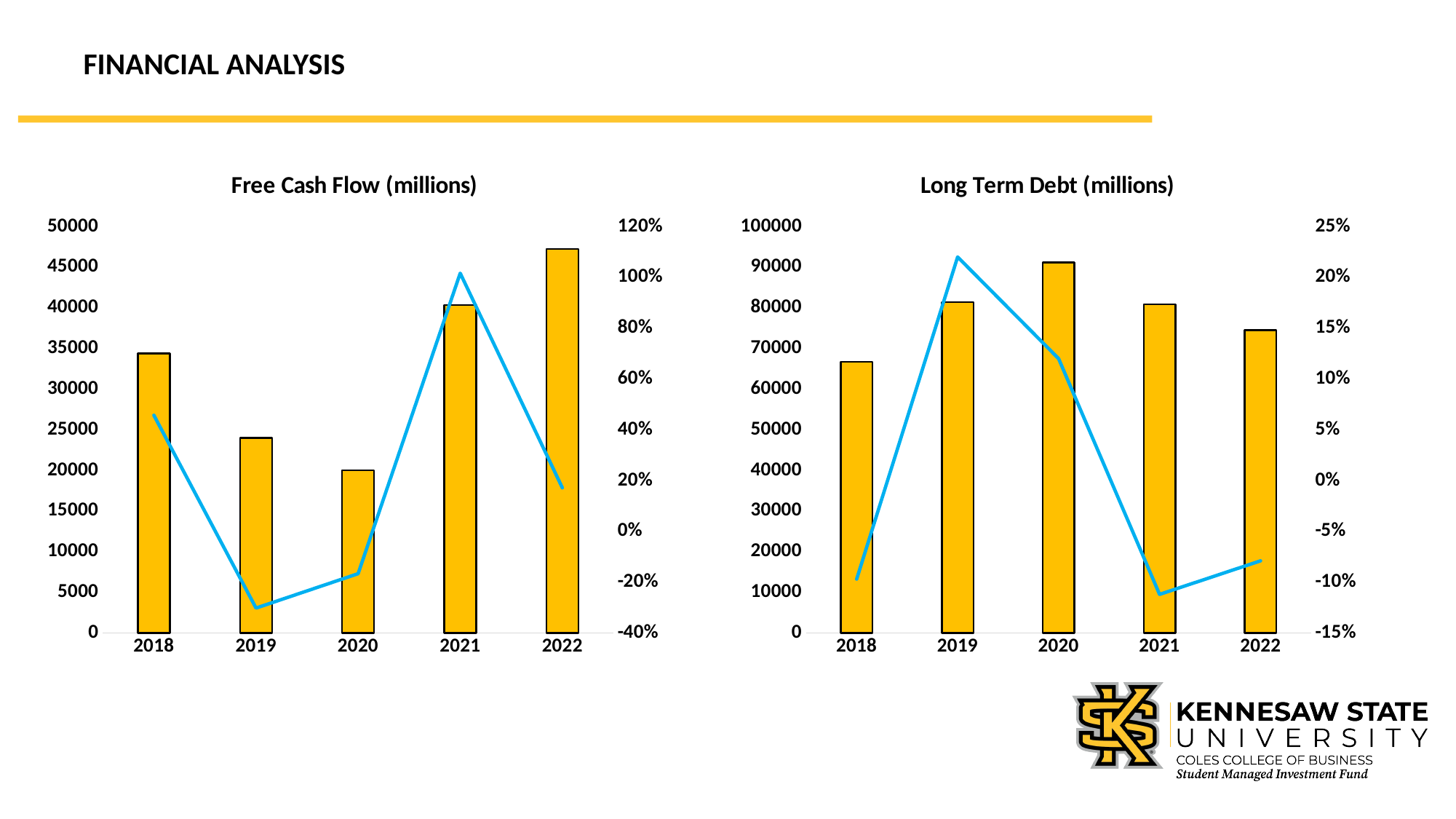
In the Long Term Debt (millions) chart, which year has the highest point on the line? 2019 In the Free Cash Flow (millions) chart, which year has the tallest bar? 2022 In the Free Cash Flow (millions) chart, is the bar for 2018 greater or less than 30000? greater In the Long Term Debt (millions) chart, which year has the shortest bar? 2018 In the Long Term Debt (millions) chart, is the bar for 2022 greater or less than 70000? greater In the Long Term Debt (millions) chart, which year has the tallest bar? 2020 In the Free Cash Flow (millions) chart, which year has the lowest point on the line? 2019 In the Free Cash Flow (millions) chart, which year has the shortest bar? 2020 In the Free Cash Flow (millions) chart, is the bar for 2019 greater or less than 25000? less How many years are shown on the x axis of the Free Cash Flow (millions) chart? 5 In the Long Term Debt (millions) chart, is the bar for 2019 taller than the bar for 2022? Yes